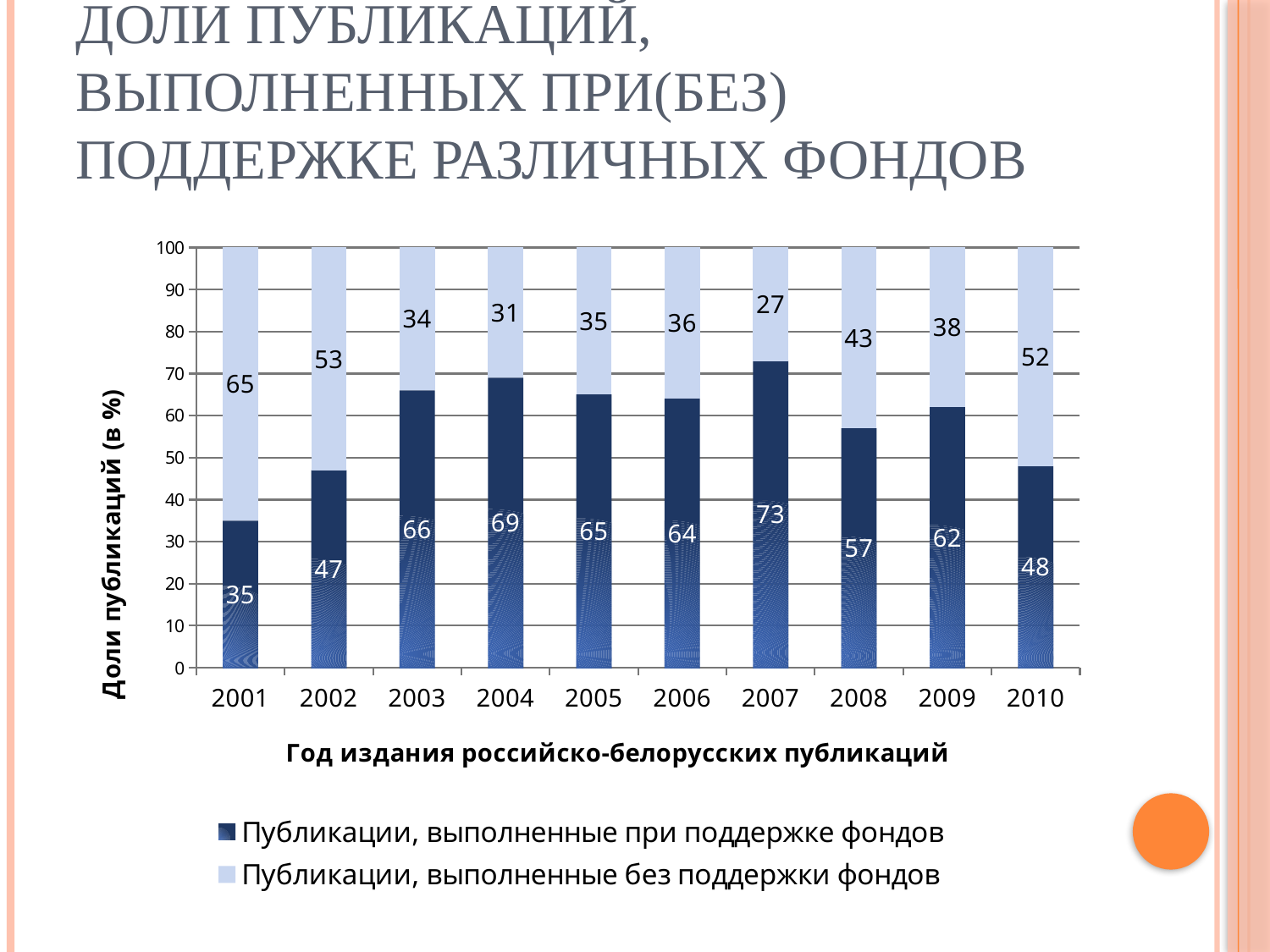
What is the label of the x axis? Год издания российско-белорусских публикаций What is the value for publications supported by funds (Публикации, выполненные при поддержке фондов) in 2007? 73 In which year is the share of publications supported by funds the lowest? 2001 What is the value for publications supported by funds in 2010? 48 What is the difference between the supported-by-funds values for 2004 and 2002? 22 Which is larger: the share of publications without fund support in 2008 or in 2009? 2008 What is the total of the stacked bar for 2005? 100 How many years are shown on the x axis? 10 What kind of chart is shown on the slide? Stacked bar chart What is the value for publications without fund support (Публикации, выполненные без поддержки фондов) in 2001? 65 In which year is the share of publications supported by funds the highest? 2007 How many series does the legend list? 2